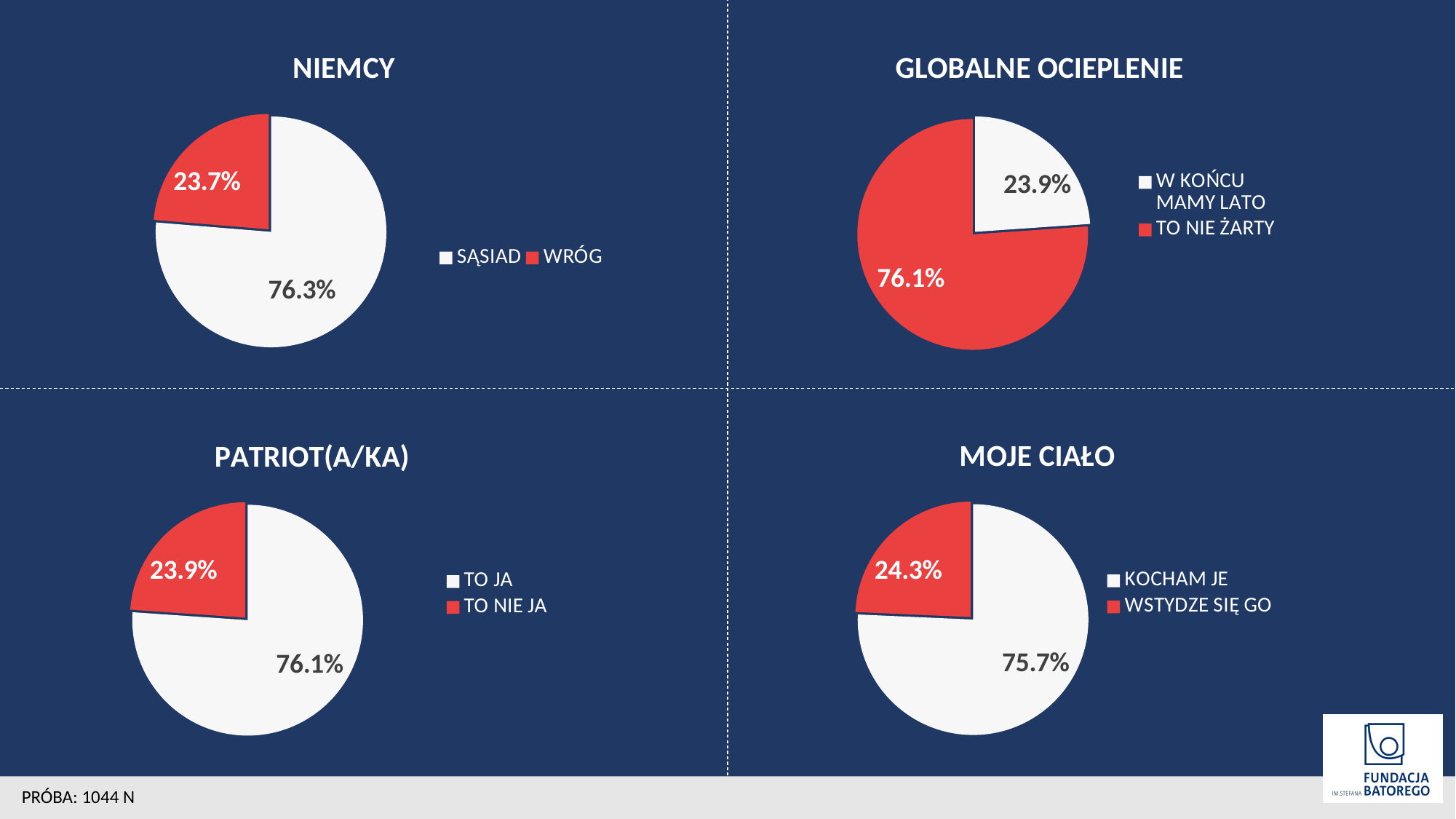
In the GLOBALNE OCIEPLENIE chart, which slice is the smallest? W KOŃCU MAMY LATO In the MOJE CIAŁO chart, what is the value for KOCHAM JE? 75.7% In the NIEMCY chart, what is the value for SĄSIAD? 76.3% How many slices does the PATRIOT(A/KA) chart have? 2 In the PATRIOT(A/KA) chart, which is larger, TO JA or TO NIE JA? TO JA In the GLOBALNE OCIEPLENIE chart, what is the value for W KOŃCU MAMY LATO? 23.9% In the MOJE CIAŁO chart, which slice is the largest? KOCHAM JE In the GLOBALNE OCIEPLENIE chart, what is the value for TO NIE ŻARTY? 76.1% In the NIEMCY chart, what is the difference between the SĄSIAD and WRÓG values? 52.6% What kind of chart is used for MOJE CIAŁO? Pie chart In the PATRIOT(A/KA) chart, what is the value for TO NIE JA? 23.9% In the NIEMCY chart, what is the value for WRÓG? 23.7%